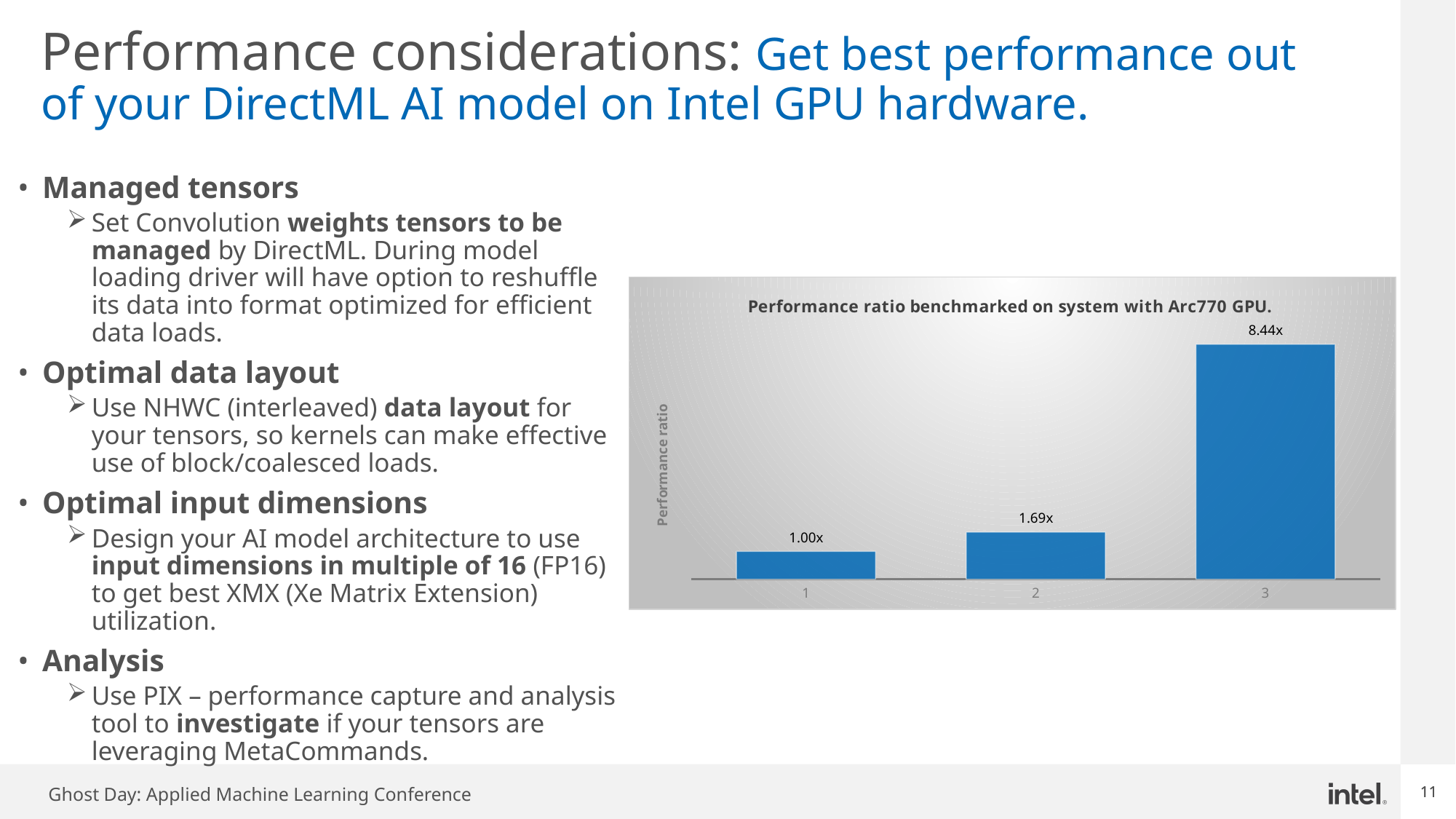
What is the title of the chart? Performance ratio benchmarked on system with Arc770 GPU. Do the performance ratio values rise or fall from category 1 to category 3? rise Which category has the highest performance ratio? 3 Which category has the lowest performance ratio? 1 What is the performance ratio for category 1? 1.00x Which has a larger performance ratio, category 2 or category 3? 3 What is the difference between the performance ratio for category 3 and category 2? 6.75x How many categories are shown in the chart? 3 What is the difference between the performance ratio for category 2 and category 1? 0.69x What kind of chart is shown on the slide? bar chart What is the performance ratio for category 2? 1.69x What is the performance ratio for category 3? 8.44x